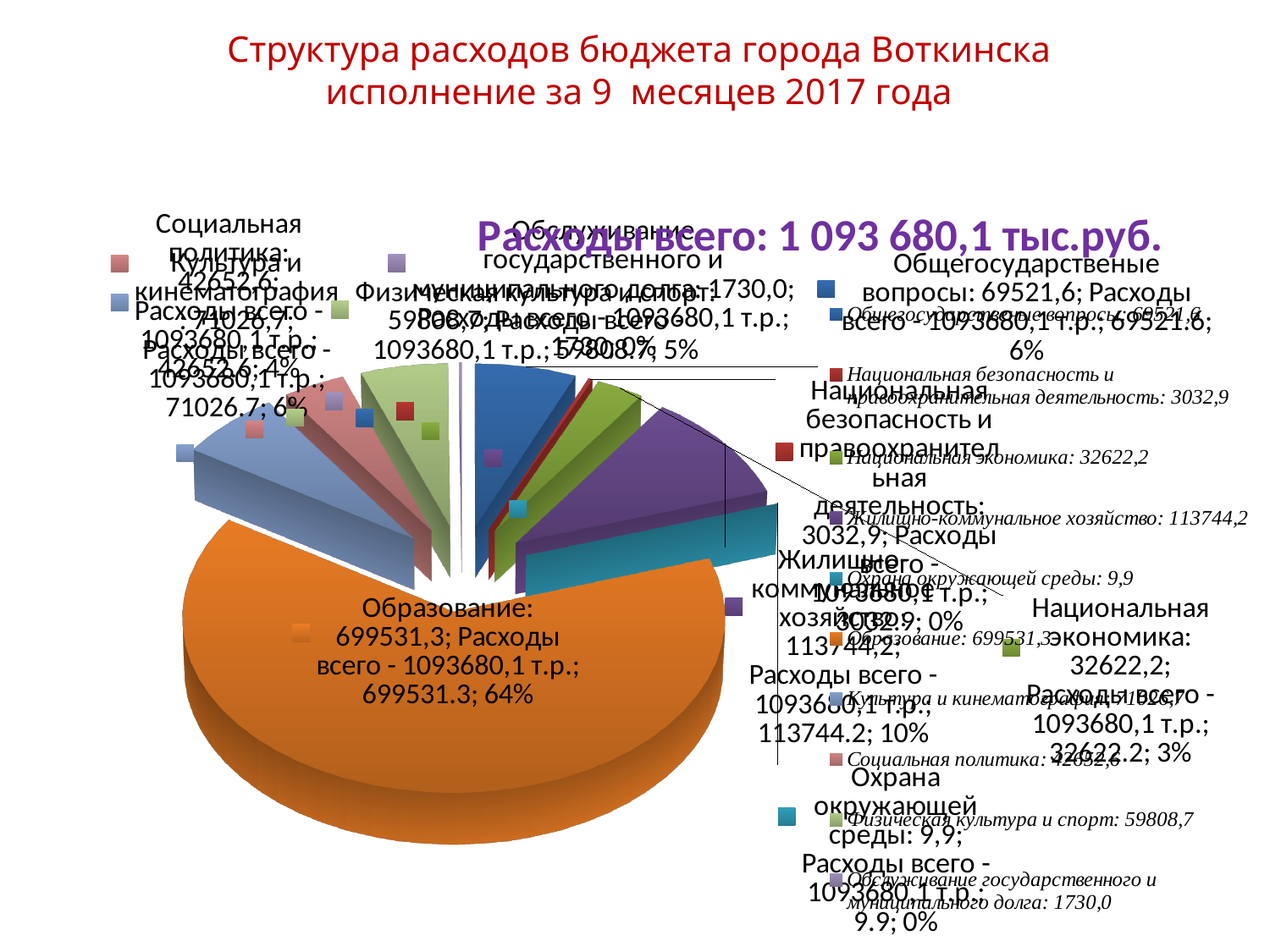
What is the value for Обслуживание государственного и муниципального долга? 1730,0 How many categories does the legend list? 10 What is the value for Общегосударственные вопросы? 69521,6 What kind of chart is shown on the slide? pie chart What is the value for Образование? 699531,3 Which category has the largest share of the pie? Образование What share of the pie does Образование represent? 64% What is the value for Жилищно-коммунальное хозяйство? 113744,2 What share of the pie does Жилищно-коммунальное хозяйство represent? 10% What is the difference between the values for Жилищно-коммунальное хозяйство and Общегосударственные вопросы? 44222,6 Which category has the smallest value? Охрана окружающей среды Which is larger, Культура и кинематография or Физическая культура и спорт? Культура и кинематография